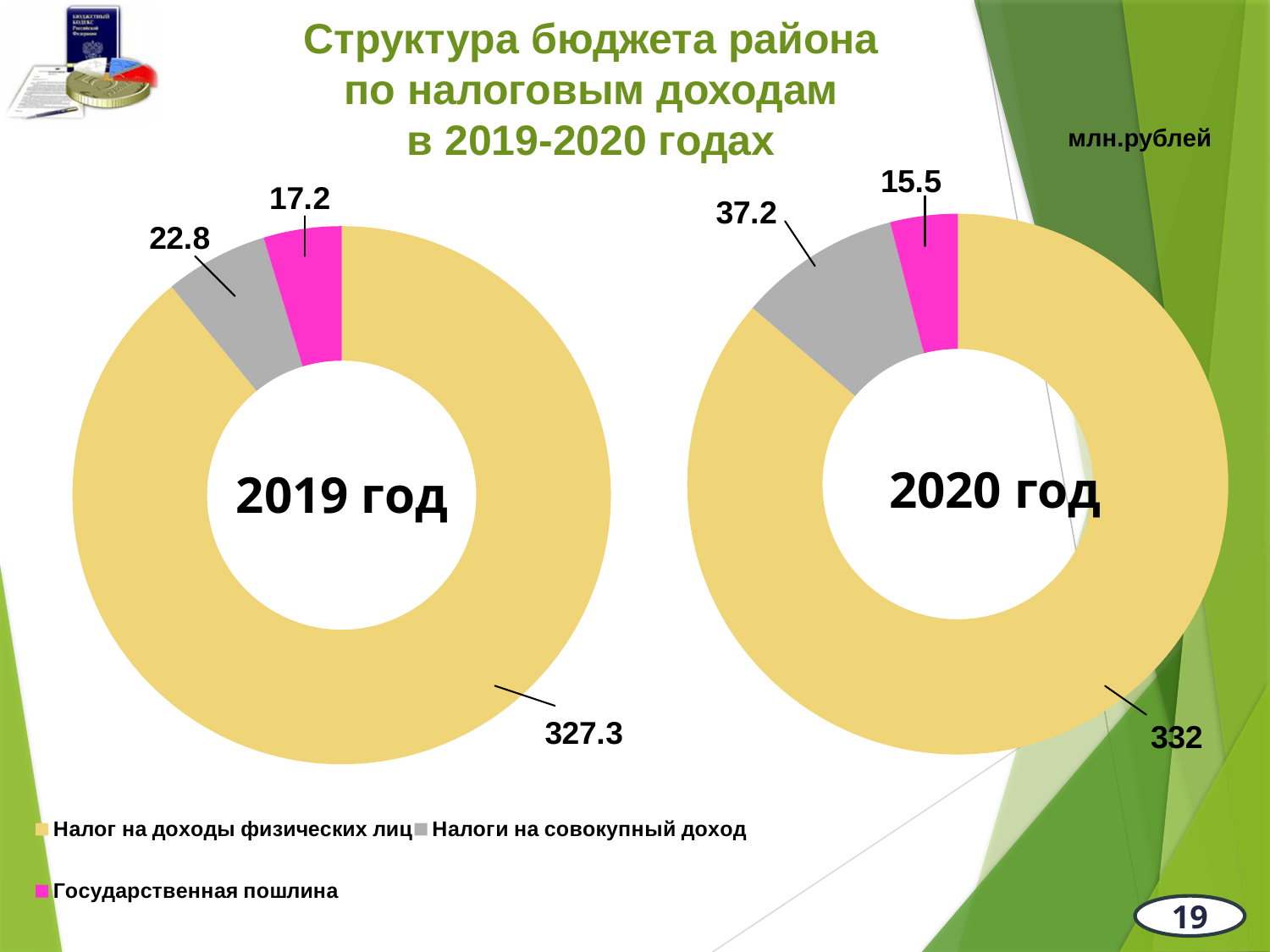
In the 2019 год chart, which category has the smallest value? Государственная пошлина How many categories does each donut chart show? 3 What is the difference between Налоги на совокупный доход in the 2020 год chart and in the 2019 год chart? 14.4 In the 2019 год chart, what is the value for Государственная пошлина? 17.2 What type of chart is used for 2019 год and 2020 год? Donut (pie) chart In the 2020 год chart, what is the value for Налоги на совокупный доход? 37.2 In the 2020 год chart, which category has the largest value? Налог на доходы физических лиц Which colour represents Налоги на совокупный доход in the legend? Grey Which is larger: Государственная пошлина in the 2019 год chart or in the 2020 год chart? 2019 год In the 2020 год chart, what is the value for Государственная пошлина? 15.5 In the 2019 год chart, what is the value for Налог на доходы физических лиц? 327.3 What unit of measurement is indicated on the slide for the chart values? млн.рублей